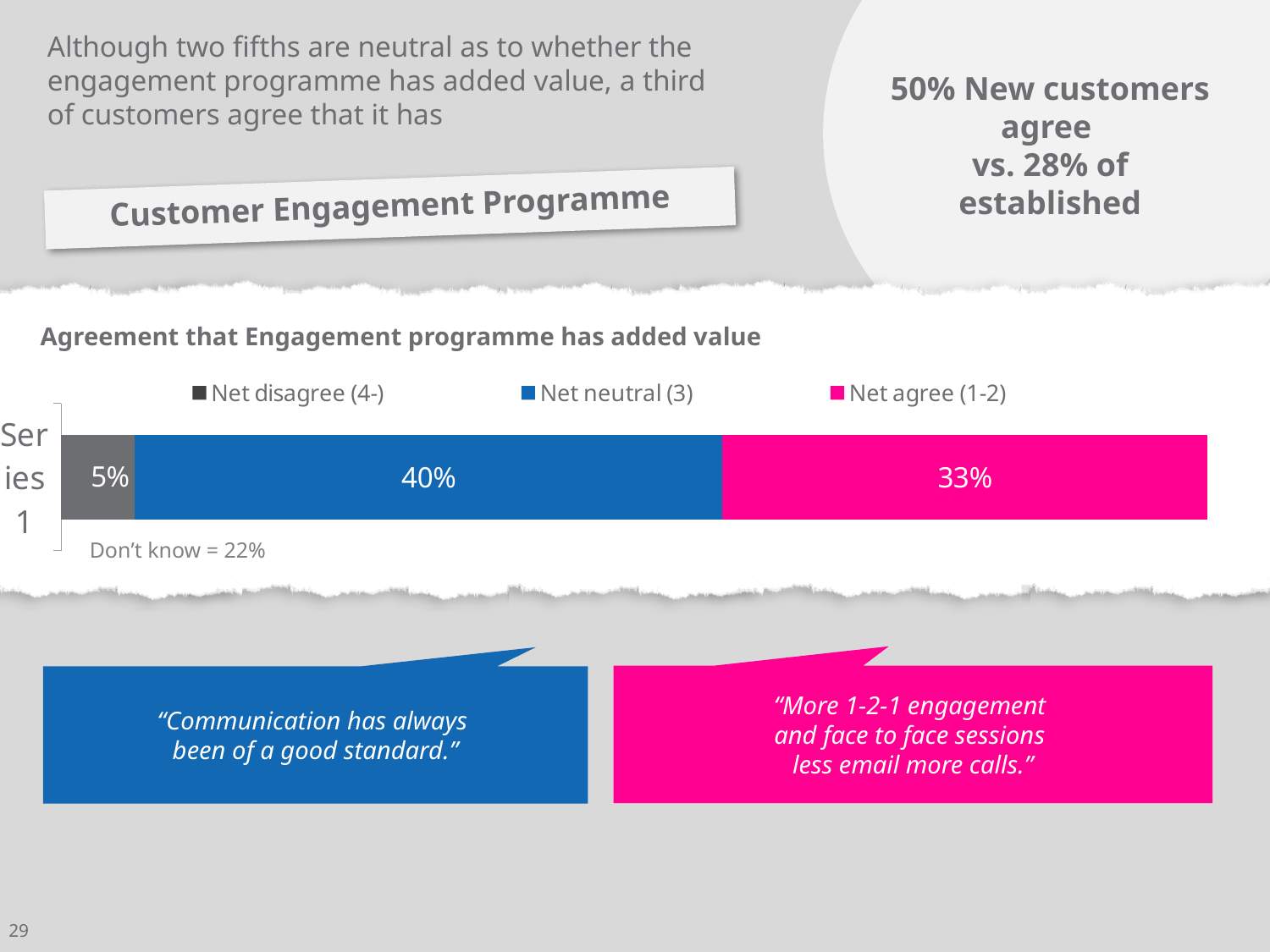
Which is larger: the share for net agree (1-2) or net disagree (4-)? Net agree (1-2) Which response category has the smallest share in the chart? Net disagree (4-) How many series does the legend list? 3 What percentage of customers net agree (1-2) that the engagement programme has added value? 33% What percentage of customers net disagree (4-) that the engagement programme has added value? 5% What kind of chart is shown on the slide? Stacked bar chart Which response category has the largest share in the chart? Net neutral (3) What is the combined total of the three segments shown in the stacked bar? 78% What is the difference in percentage points between net agree (1-2) and net disagree (4-)? 28 What is the title of the chart? Agreement that Engagement programme has added value What is the difference in percentage points between net neutral (3) and net agree (1-2)? 7 What percentage of customers are net neutral (3) about whether the engagement programme has added value? 40%